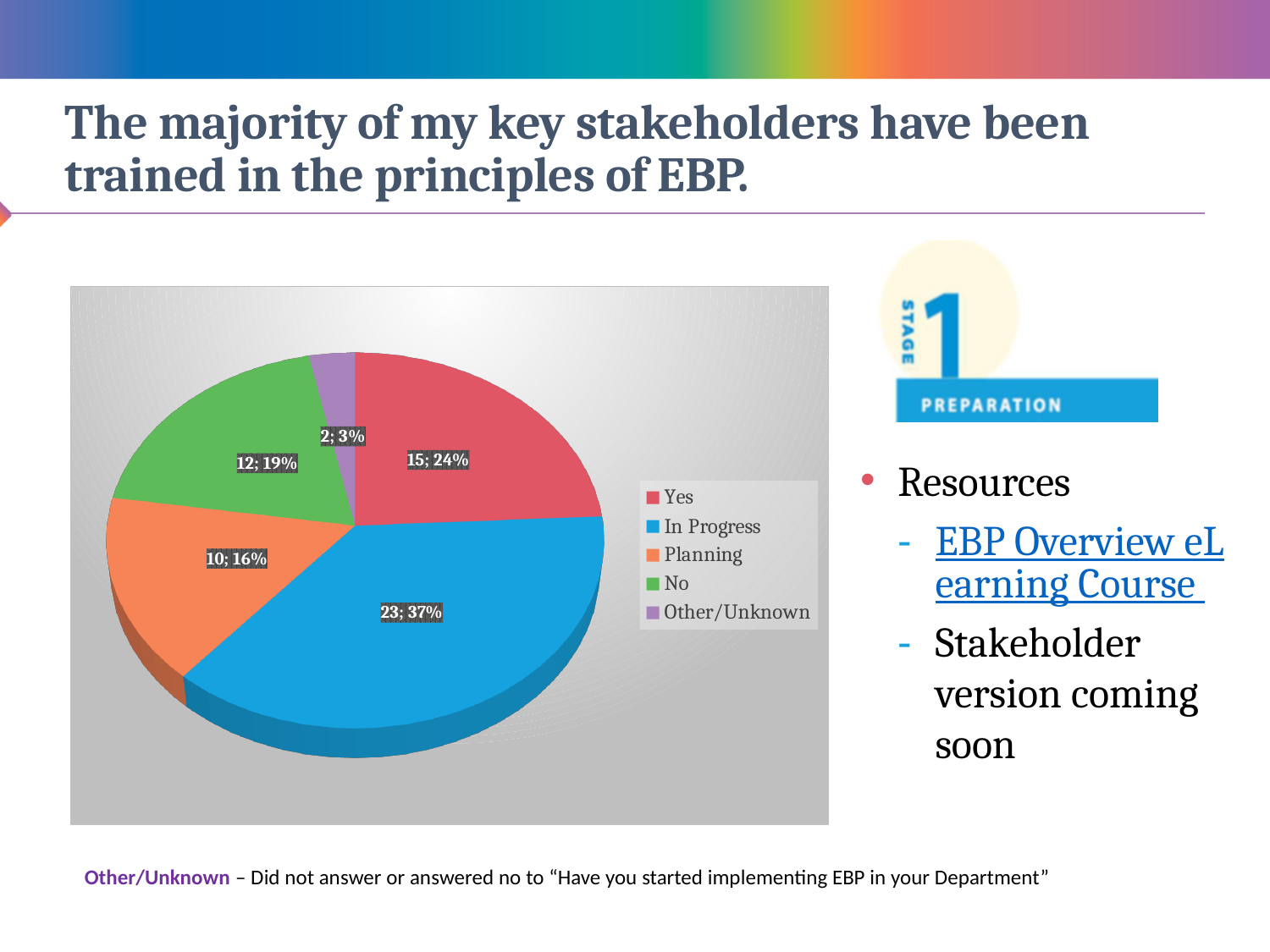
What is the count for the 'In Progress' slice? 23 How many entries does the legend list? 5 Which category has the largest slice? In Progress What kind of chart is shown on the slide? Pie chart How many categories does the pie chart have? 5 What colour is the 'Other/Unknown' slice? Purple Which is larger, the 'No' slice or the 'Planning' slice? No What percentage of the pie does the 'No' slice represent? 19% What is the difference in count between 'In Progress' and 'Yes'? 8 What is the count for the 'Planning' slice? 10 Which category has the smallest slice? Other/Unknown What percentage of the pie does the 'Yes' slice represent? 24%